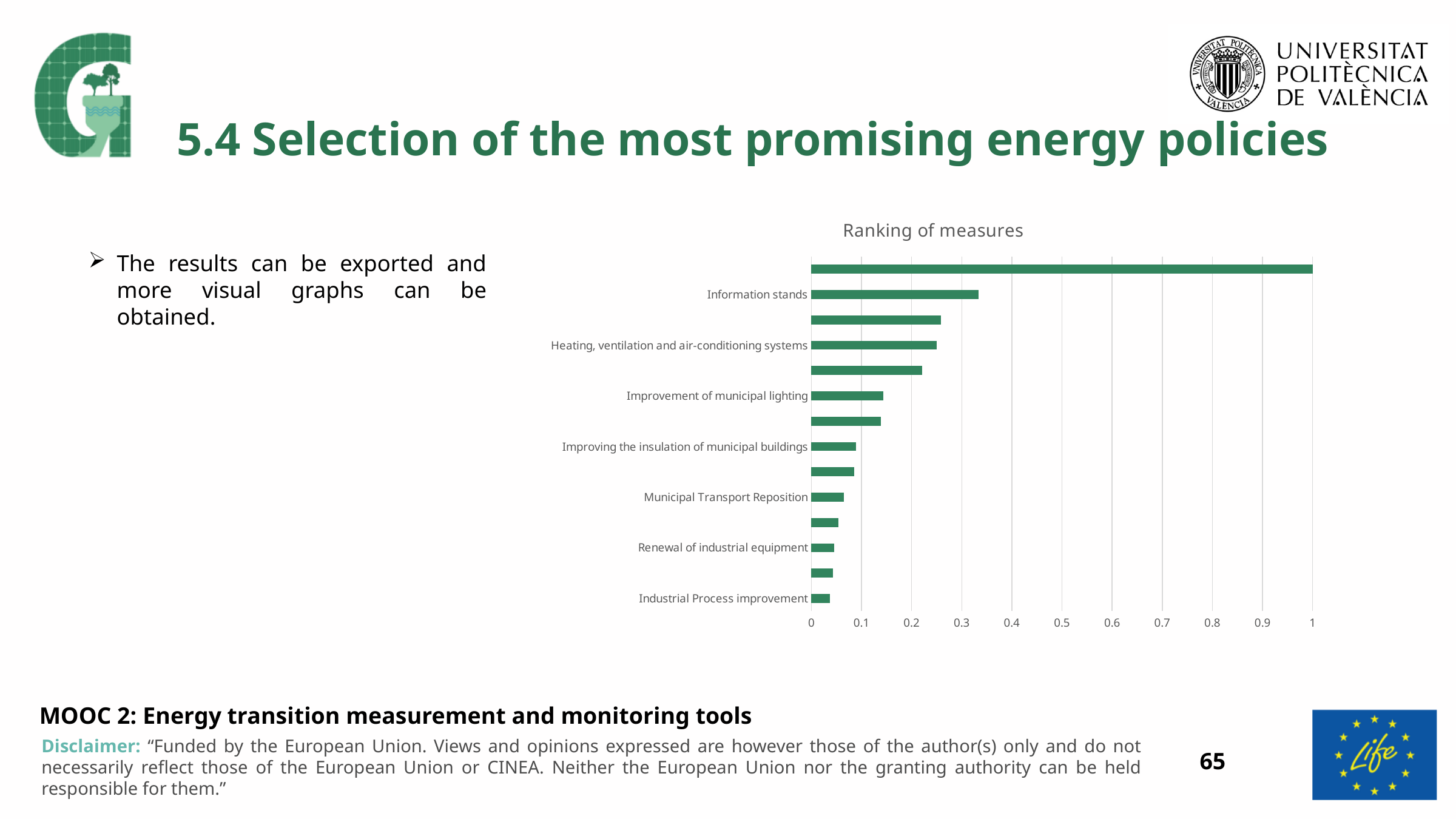
Is the value for Heating, ventilation and air-conditioning systems greater or less than 0.3? less Is the value for Improvement of municipal lighting greater or less than 0.1? greater What is the title of the chart? Ranking of measures Which has the larger value, Information stands or Heating, ventilation and air-conditioning systems? Information stands What colour are the bars in the chart? green What kind of chart is shown on the slide? bar chart Is the value for Industrial Process improvement greater or less than 0.1? less Which has the larger value, Improvement of municipal lighting or Renewal of industrial equipment? Improvement of municipal lighting Do the bar values increase or decrease going from the top of the chart to the bottom? decrease Among the labelled categories, which has the highest value? Information stands